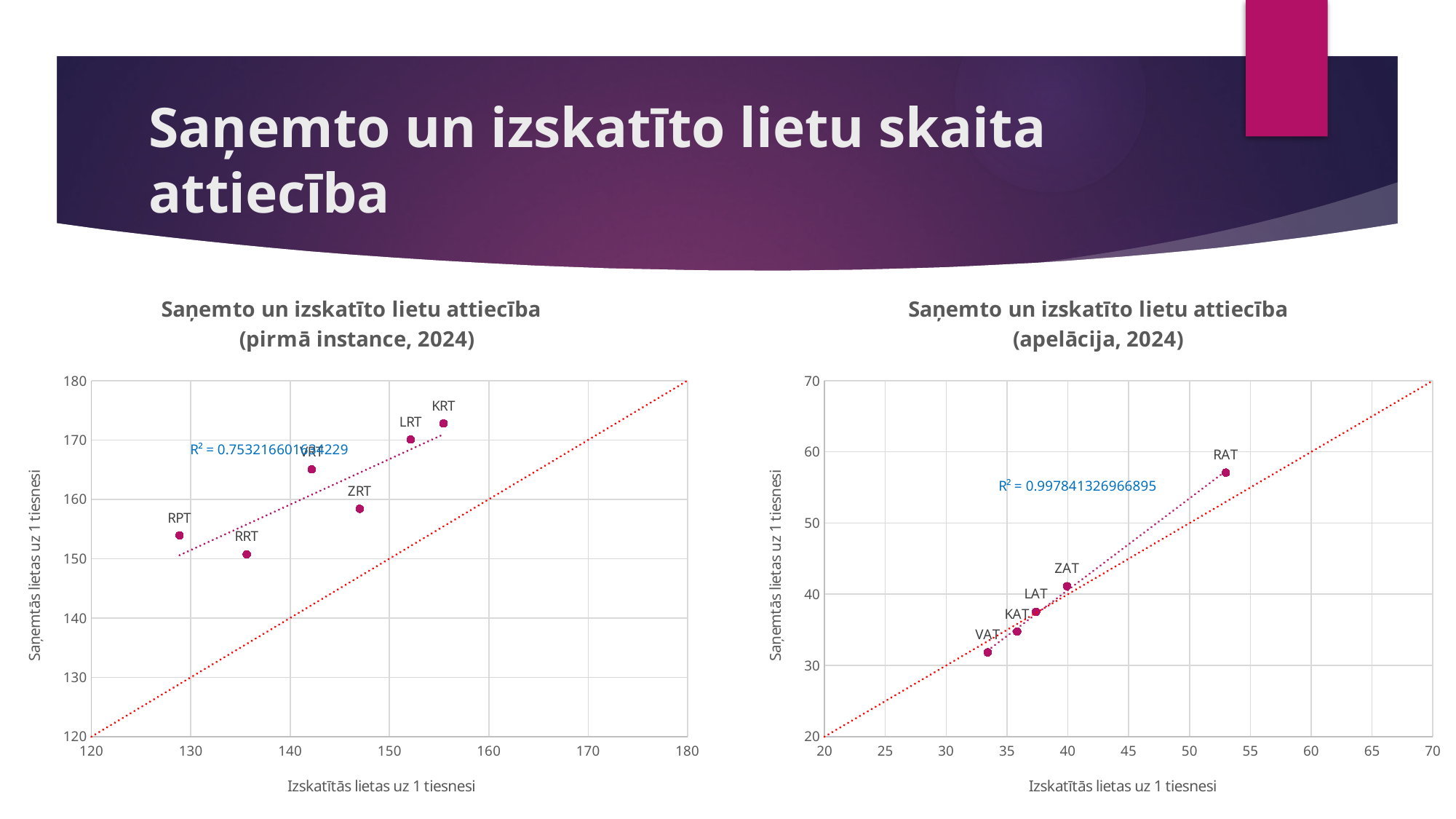
What kind of chart is the left chart titled "Saņemto un izskatīto lietu attiecība (pirmā instance, 2024)"? scatter chart In the left chart (pirmā instance, 2024), how many labelled data points are plotted? 6 In the right chart (apelācija, 2024), which court has the lowest value of Izskatītās lietas uz 1 tiesnesi? VAT In the right chart (apelācija, 2024), how many labelled data points are plotted? 5 What R² value is shown on the right chart (apelācija, 2024)? 0.997841326966895 In the left chart (pirmā instance, 2024), which court has the lowest value of Saņemtās lietas uz 1 tiesnesi? RRT In the left chart (pirmā instance, 2024), is the Izskatītās lietas uz 1 tiesnesi value for RRT greater or less than 140? less In the right chart (apelācija, 2024), is the Izskatītās lietas uz 1 tiesnesi value for RAT greater or less than 50? greater In the right chart (apelācija, 2024), which court has the highest value of Saņemtās lietas uz 1 tiesnesi? RAT In the left chart (pirmā instance, 2024), which court has the higher Saņemtās lietas uz 1 tiesnesi value, LRT or ZRT? LRT In the left chart (pirmā instance, 2024), which court has the highest value of Saņemtās lietas uz 1 tiesnesi? KRT In the left chart (pirmā instance, 2024), is the Saņemtās lietas uz 1 tiesnesi value for RPT greater or less than 150? greater